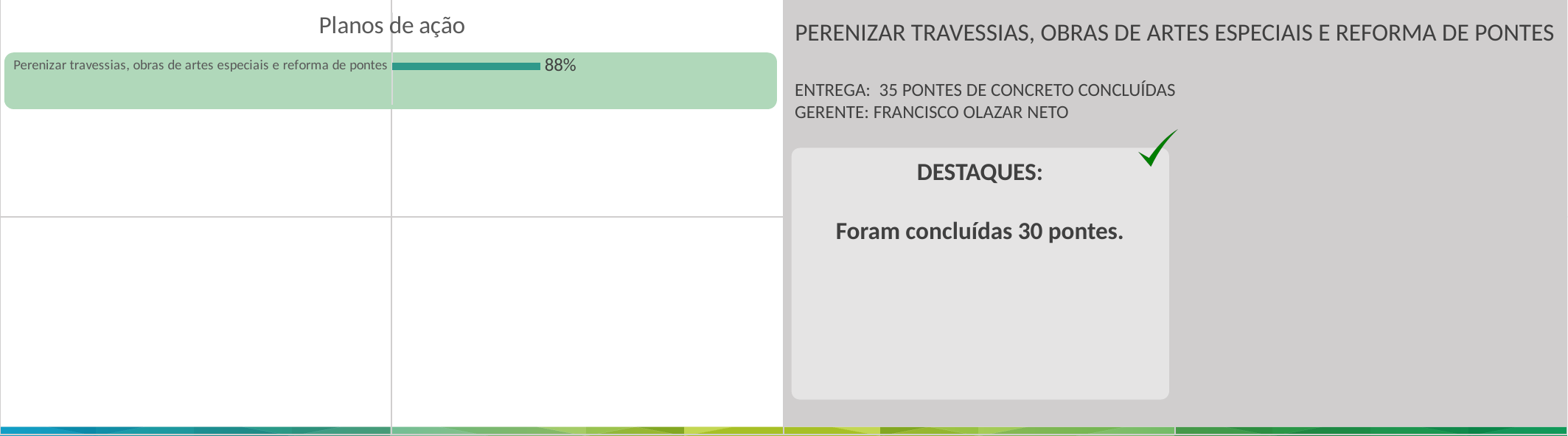
Which category has the highest value in the "Planos de ação" chart? Perenizar travessias, obras de artes especiais e reforma de pontes What kind of chart is shown under the title "Planos de ação"? bar chart Is the value for "Perenizar travessias, obras de artes especiais e reforma de pontes" greater or less than 50%? greater Is the value for "Perenizar travessias, obras de artes especiais e reforma de pontes" greater or less than 100%? less What is the value shown for "Perenizar travessias, obras de artes especiais e reforma de pontes" in the chart? 88% What is the title of the chart on the slide? Planos de ação Are the bars in the "Planos de ação" chart horizontal or vertical? horizontal How many categories are plotted in the "Planos de ação" chart? 1